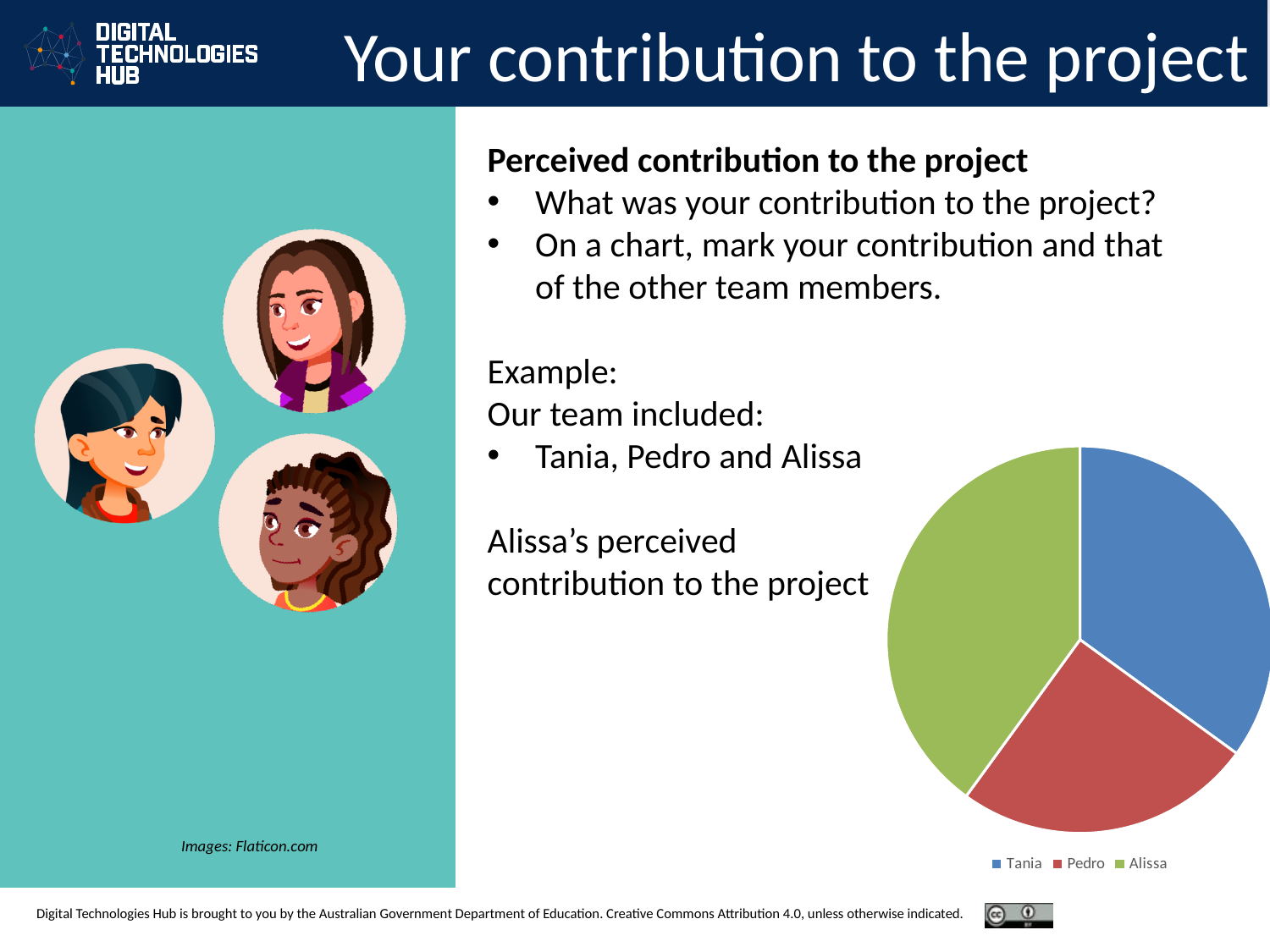
Which team member is represented by the green slice in the pie chart? Alissa What are the three names listed in the pie chart's legend? Tania, Pedro, Alissa How many slices does the pie chart have? 3 In the pie chart, is Tania's slice larger or smaller than Pedro's? larger What kind of chart is shown on the slide? pie chart In the pie chart, is Alissa's slice larger or smaller than Pedro's? larger Which team member has the smallest slice in the pie chart? Pedro How many entries does the legend of the pie chart list? 3